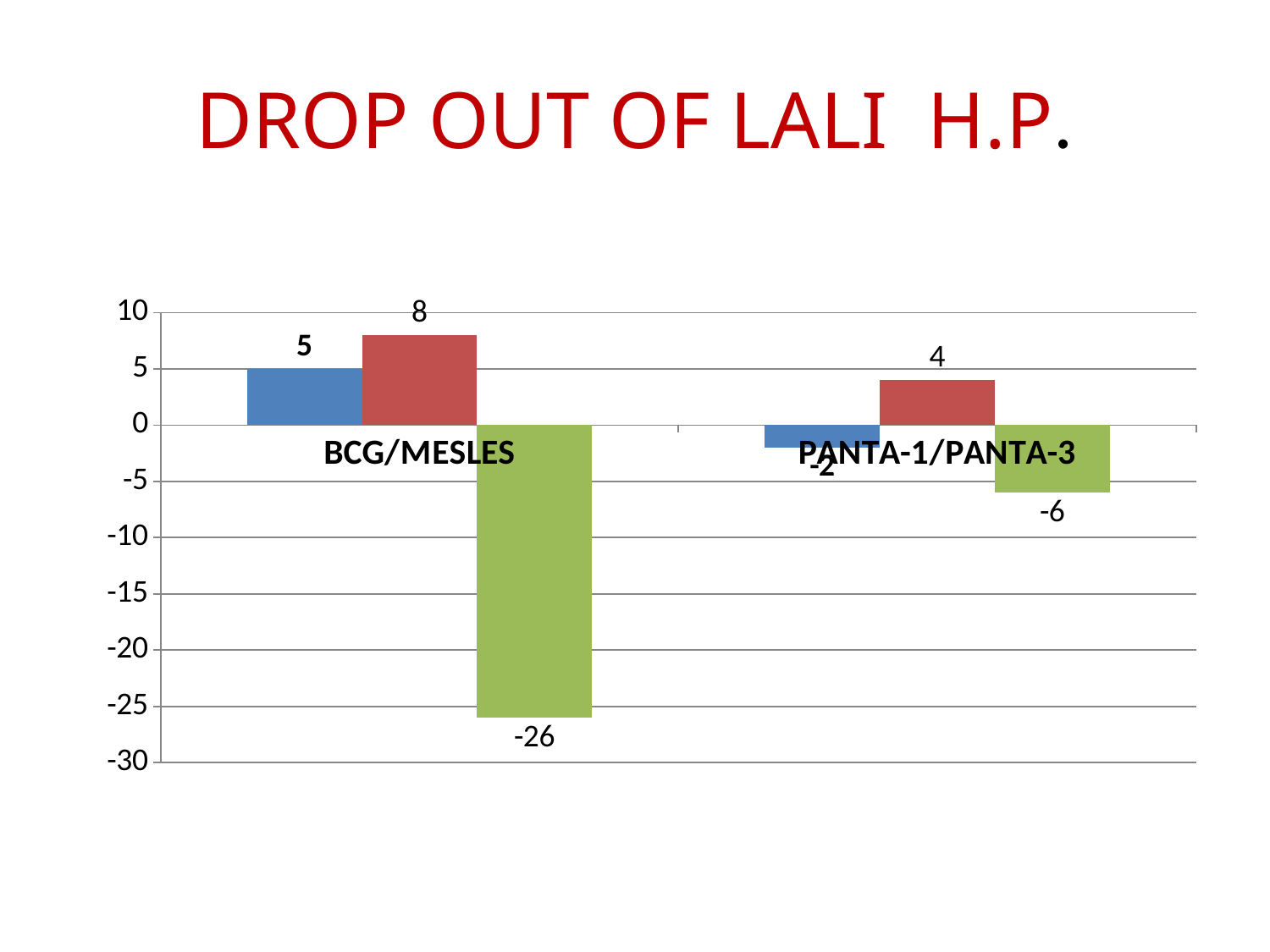
What is the difference between the red bar values for BCG/MESLES and PANTA-1/PANTA-3? 4 Which bar has the lowest value on the chart? The green bar for BCG/MESLES (-26) What is the value of the blue bar for BCG/MESLES? 5 What is the value of the blue bar for PANTA-1/PANTA-3? -2 What is the value of the green bar for BCG/MESLES? -26 How many categories are shown on the x axis? 2 Which is larger, the green bar for BCG/MESLES or the green bar for PANTA-1/PANTA-3? PANTA-1/PANTA-3 What is the value of the red bar for PANTA-1/PANTA-3? 4 What type of chart is shown on the slide? Bar chart What is the value of the green bar for PANTA-1/PANTA-3? -6 What is the value of the red bar for BCG/MESLES? 8 Which bar has the highest value on the chart? The red bar for BCG/MESLES (8)